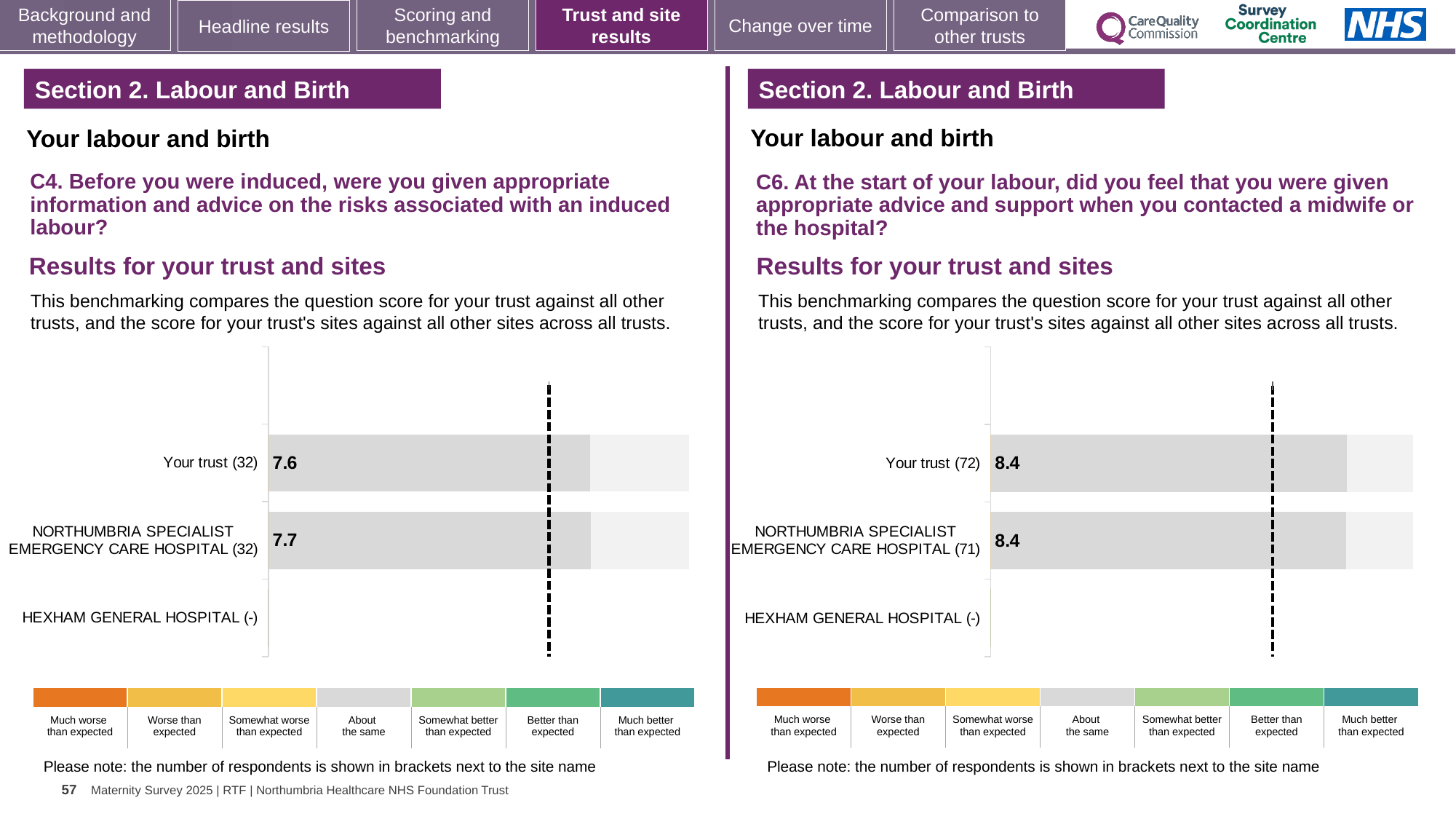
In the C4 chart on the left, what is the difference between the scores for Northumbria Specialist Emergency Care Hospital and Your trust? 0.1 What kind of chart is the C4 chart on the left? bar chart In the C4 chart on the left, which has the higher score: Your trust or Northumbria Specialist Emergency Care Hospital? Northumbria Specialist Emergency Care Hospital In the C6 chart on the right, what is the score for Northumbria Specialist Emergency Care Hospital? 8.4 In the C6 chart on the right, how many respondents are shown in brackets for Your trust? 72 In the C6 chart on the right, what is the score for Your trust? 8.4 In the C4 chart on the left, what is the score for Your trust? 7.6 In the C4 chart on the left, what is the score for Northumbria Specialist Emergency Care Hospital? 7.7 In the C4 chart on the left, how many respondents are shown in brackets for Northumbria Specialist Emergency Care Hospital? 32 In the C6 chart on the right, which site has no score shown (marked with a dash)? Hexham General Hospital How many categories (rows) are listed on the y axis of the C6 chart on the right? 3 In the C6 chart on the right, how many respondents are shown in brackets for Northumbria Specialist Emergency Care Hospital? 71